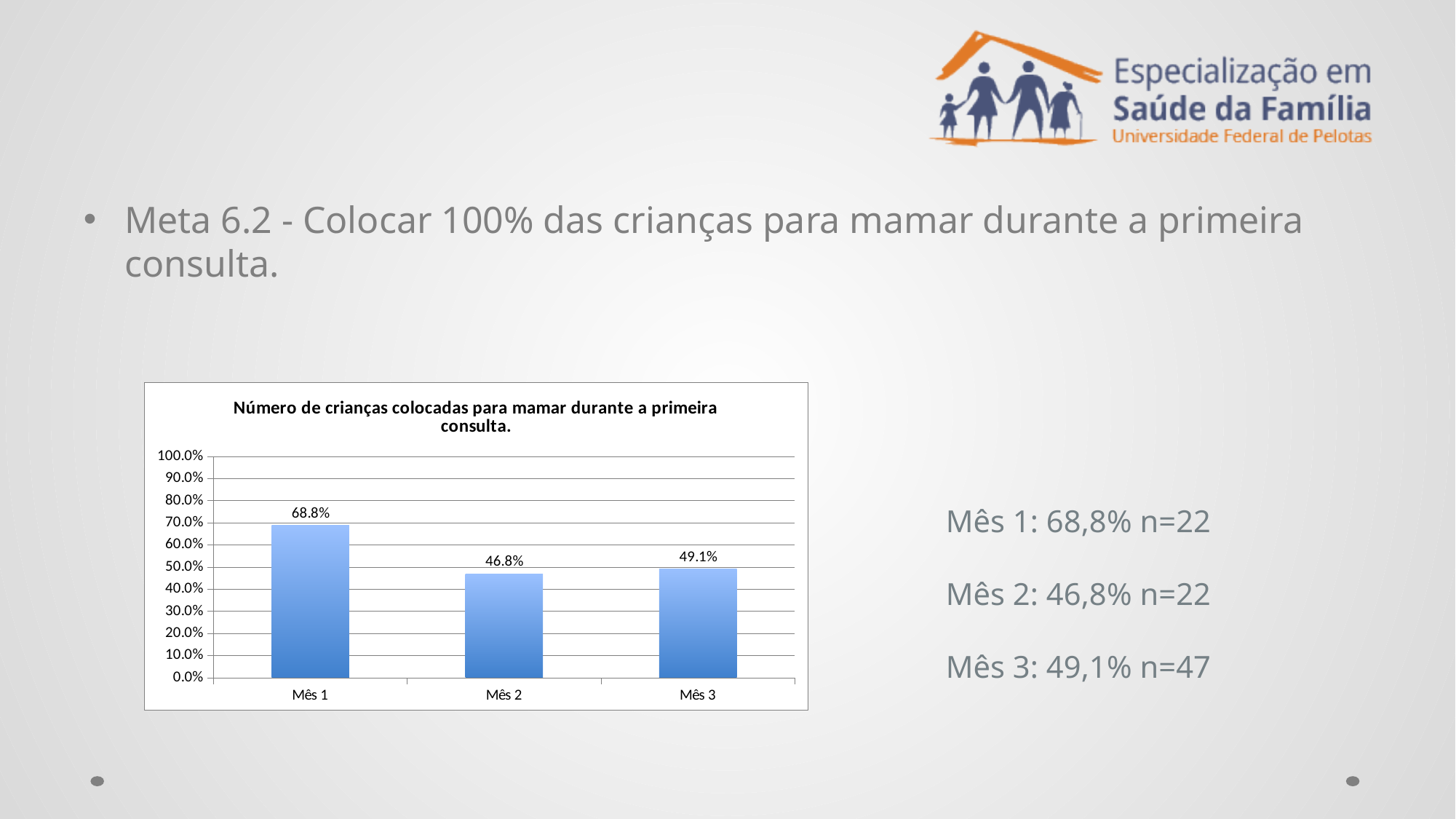
Which is larger, the value for Mês 1 or the value for Mês 3? Mês 1 What is the value for Mês 2? 46.8% What is the difference between the values for Mês 3 and Mês 2? 2.3% What is the value for Mês 1? 68.8% What is the difference between the values for Mês 1 and Mês 2? 22.0% Which month has the highest value? Mês 1 What is the value for Mês 3? 49.1% Is the value for Mês 1 greater or less than 60.0%? greater What is the title of the chart? Número de crianças colocadas para mamar durante a primeira consulta. How many months are shown on the x axis? 3 Which month has the lowest value? Mês 2 What kind of chart is shown on the slide? bar chart